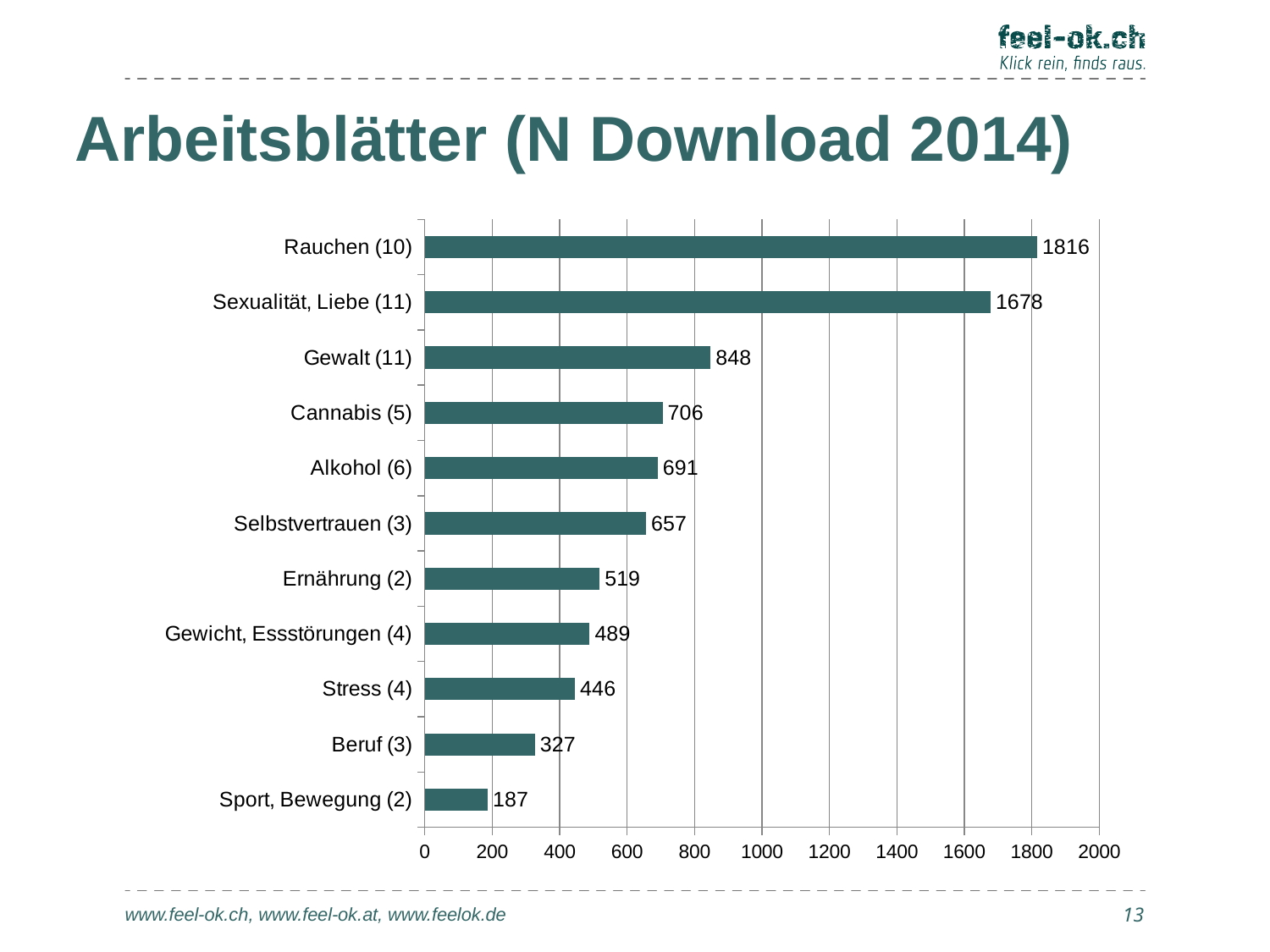
What is the title of the slide? Arbeitsblätter (N Download 2014) What is the difference between the values for Gewalt (11) and Cannabis (5)? 142 What kind of chart is shown on the slide? bar chart Which category has the lowest value? Sport, Bewegung (2) Which category has the highest value? Rauchen (10) Which is larger, the value for Alkohol (6) or the value for Selbstvertrauen (3)? Alkohol (6) What is the value for Sport, Bewegung (2)? 187 What is the value for Rauchen (10)? 1816 How many categories are shown in the chart? 11 What is the value for Gewicht, Essstörungen (4)? 489 Is the value for Ernährung (2) greater or less than 600? less What is the difference between the values for Rauchen (10) and Sexualität, Liebe (11)? 138